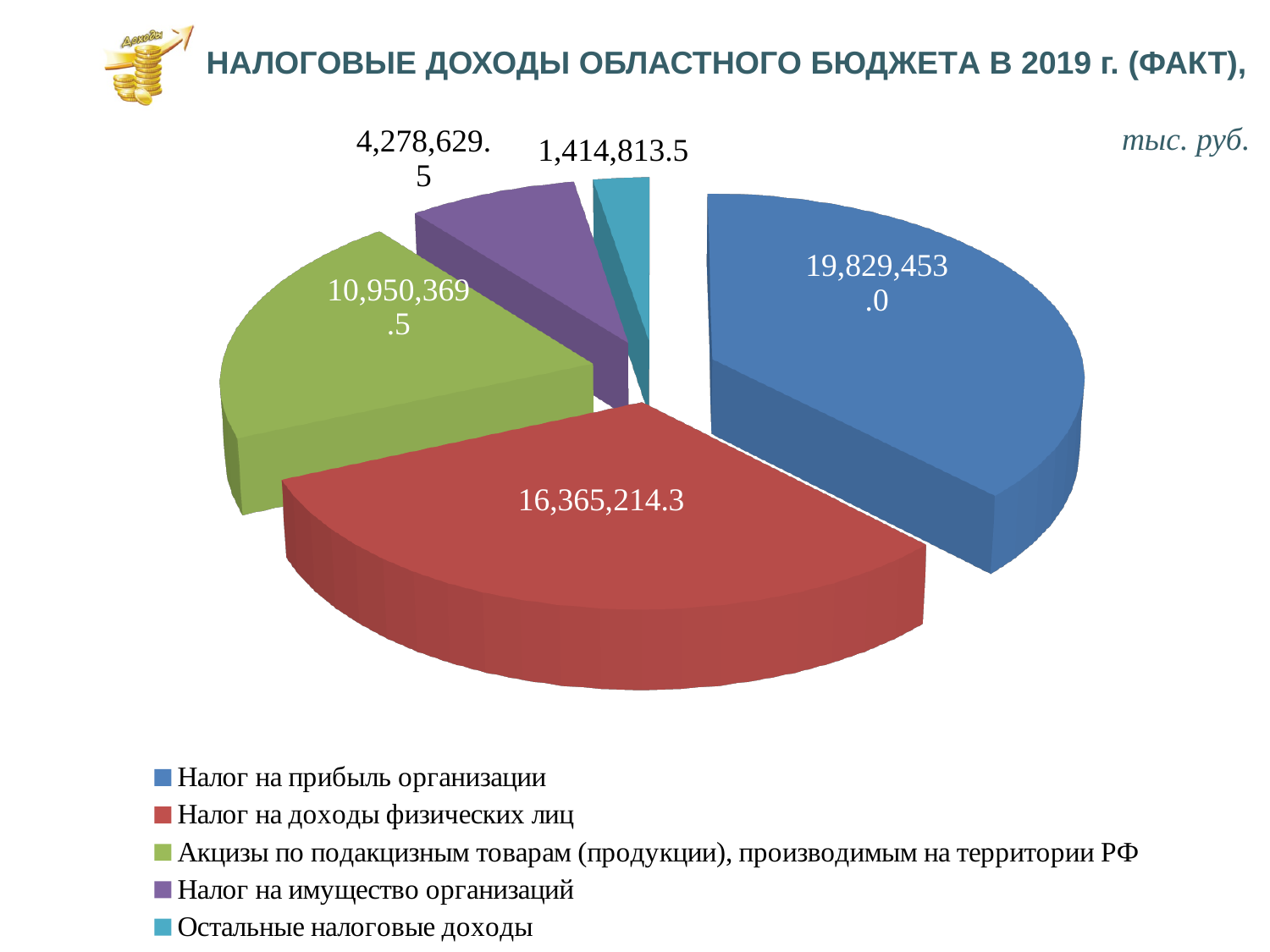
What unit of measurement is indicated on the slide for the chart values? тыс. руб. What is the value for Налог на прибыль организации? 19,829,453.0 What type of chart is shown on the slide? Pie chart Which category has the smallest value? Остальные налоговые доходы What is the value for Налог на имущество организаций? 4,278,629.5 Which is larger: Акцизы по подакцизным товарам or Налог на имущество организаций? Акцизы по подакцизным товарам What is the value for Акцизы по подакцизным товарам (продукции), производимым на территории РФ? 10,950,369.5 What is the value for Остальные налоговые доходы? 1,414,813.5 Which category has the largest value? Налог на прибыль организации How many categories does the pie chart have? 5 What is the difference between Налог на прибыль организации and Налог на доходы физических лиц? 3,464,238.7 What is the value for Налог на доходы физических лиц? 16,365,214.3